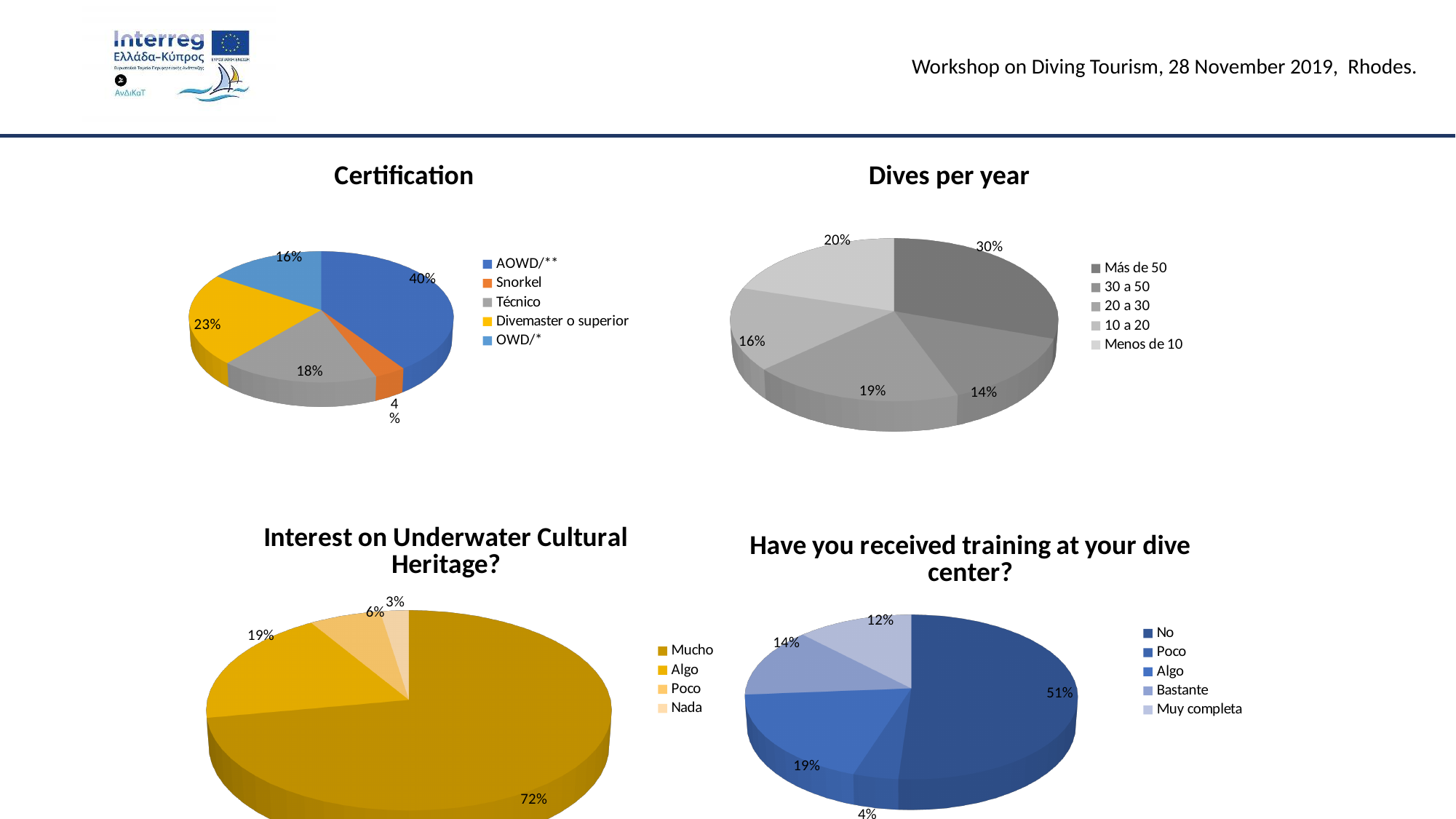
In the Interest on Underwater Cultural Heritage? chart, which category has the smallest slice? Nada In the Certification chart, which category has the largest slice? AOWD/** In the Dives per year chart, which category has the smallest share? 30 a 50 In the Dives per year chart, what share corresponds to Más de 50? 30% In the Dives per year chart, what is the difference between the Más de 50 share and the Menos de 10 share? 10% In the Certification chart, what percentage is labelled Snorkel? 4% What type of chart is used for Dives per year? Pie chart In the Interest on Underwater Cultural Heritage? chart, what share answered Mucho? 72% In the Certification chart, what share of respondents hold AOWD/**? 40% In the Have you received training at your dive center? chart, what share answered No? 51% In the Certification chart, how many categories does the legend list? 5 In the Have you received training at your dive center? chart, which is larger, Bastante or Muy completa? Bastante